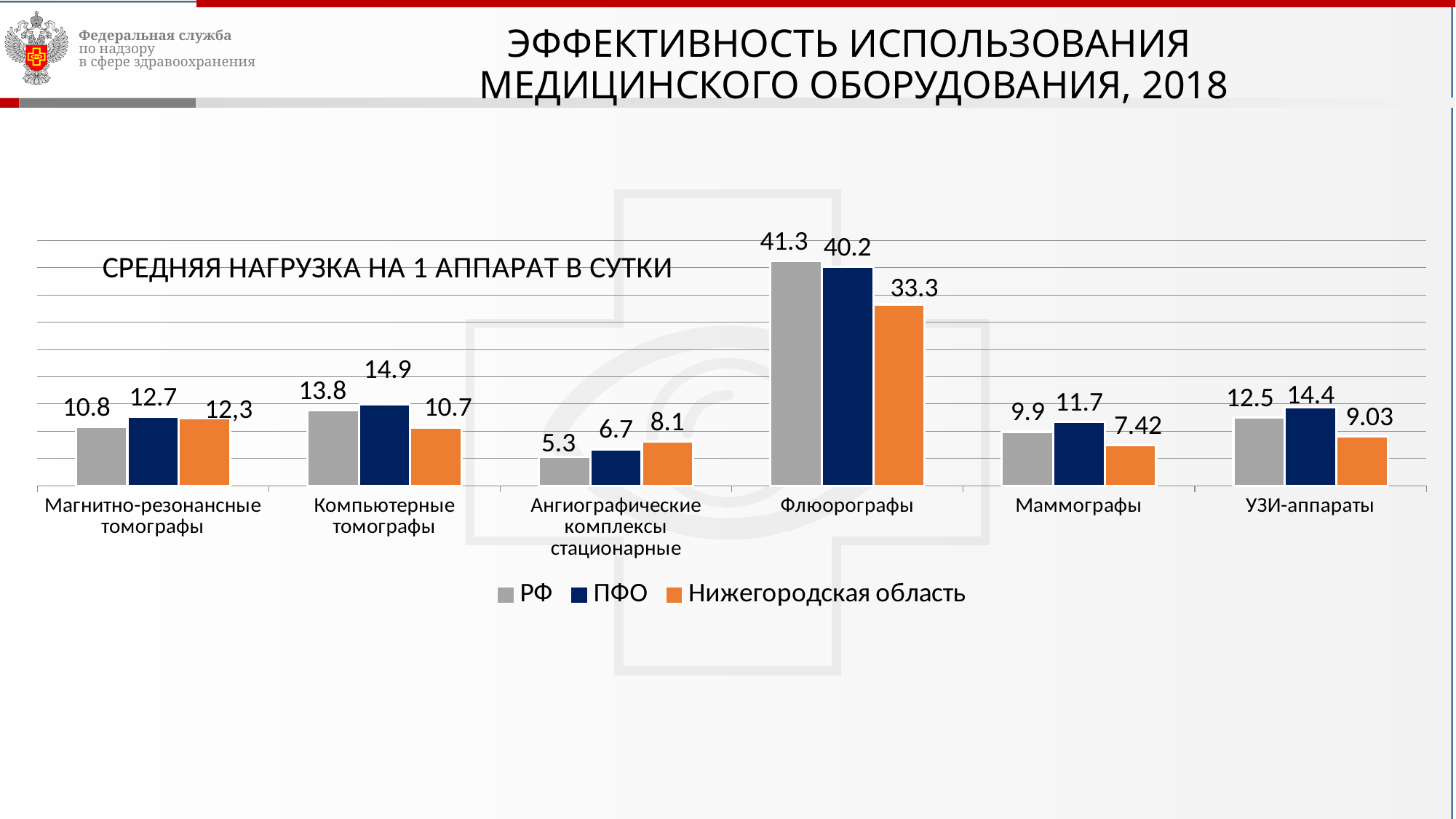
How many series does the legend list? 3 What is the value for ПФО for Компьютерные томографы? 14.9 What is the value for Нижегородская область for Магнитно-резонансные томографы? 12,3 What is the value for Нижегородская область for Маммографы? 7.42 What is the title of the chart? СРЕДНЯЯ НАГРУЗКА НА 1 АППАРАТ В СУТКИ What is the value for РФ for Флюорографы? 41.3 Which category has the lowest value for ПФО? Ангиографические комплексы стационарные Which is larger for УЗИ-аппараты: the value for ПФО or the value for Нижегородская область? ПФО What kind of chart is shown on the slide? bar chart What is the difference between the РФ and ПФО values for Флюорографы? 1.1 Which category has the highest value for РФ? Флюорографы How many categories are shown on the x axis? 6